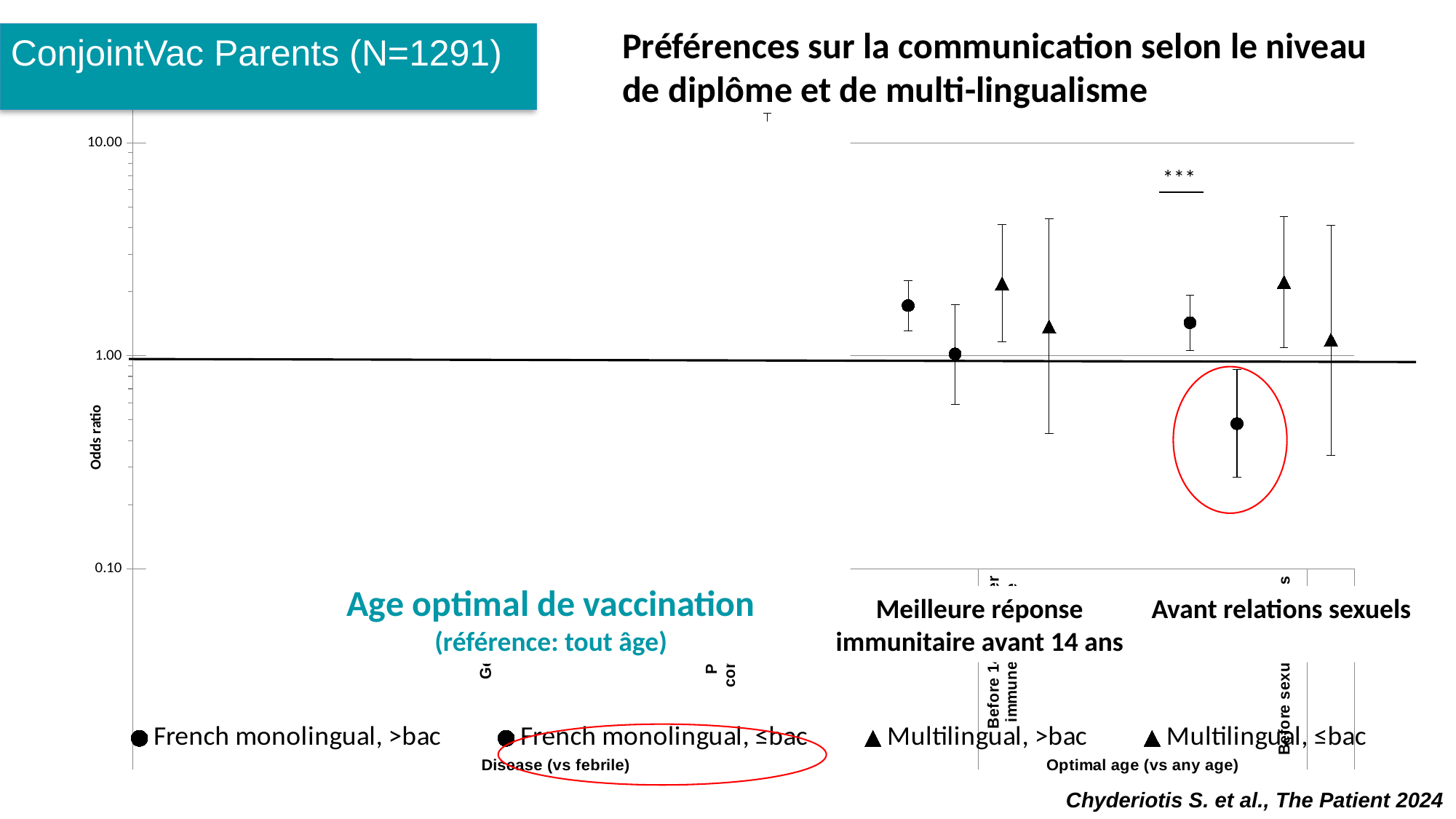
What is the reference category for the 'Age optimal de vaccination' attribute? tout âge In the 'Avant relations sexuels' category, which series has the highest odds ratio? Multilingual, >bac Is the odds ratio for French monolingual, >bac in the 'Meilleure réponse immunitaire avant 14 ans' category greater or less than 1.00? greater Which series and category is highlighted with a red circle on the chart? French monolingual, ≤bac, Avant relations sexuels What is the label of the y axis? Odds ratio In the 'Avant relations sexuels' category, which series has the lowest odds ratio? French monolingual, ≤bac Is the odds ratio for French monolingual, ≤bac in the 'Avant relations sexuels' category greater or less than 1.00? less In the 'Avant relations sexuels' category, which is larger: the odds ratio for French monolingual, >bac or for French monolingual, ≤bac? French monolingual, >bac Is the odds ratio for Multilingual, >bac in the 'Meilleure réponse immunitaire avant 14 ans' category greater or less than 1.00? greater What kind of chart is shown on the slide? Scatter (dot) plot with error bars How many series does the legend list? 4